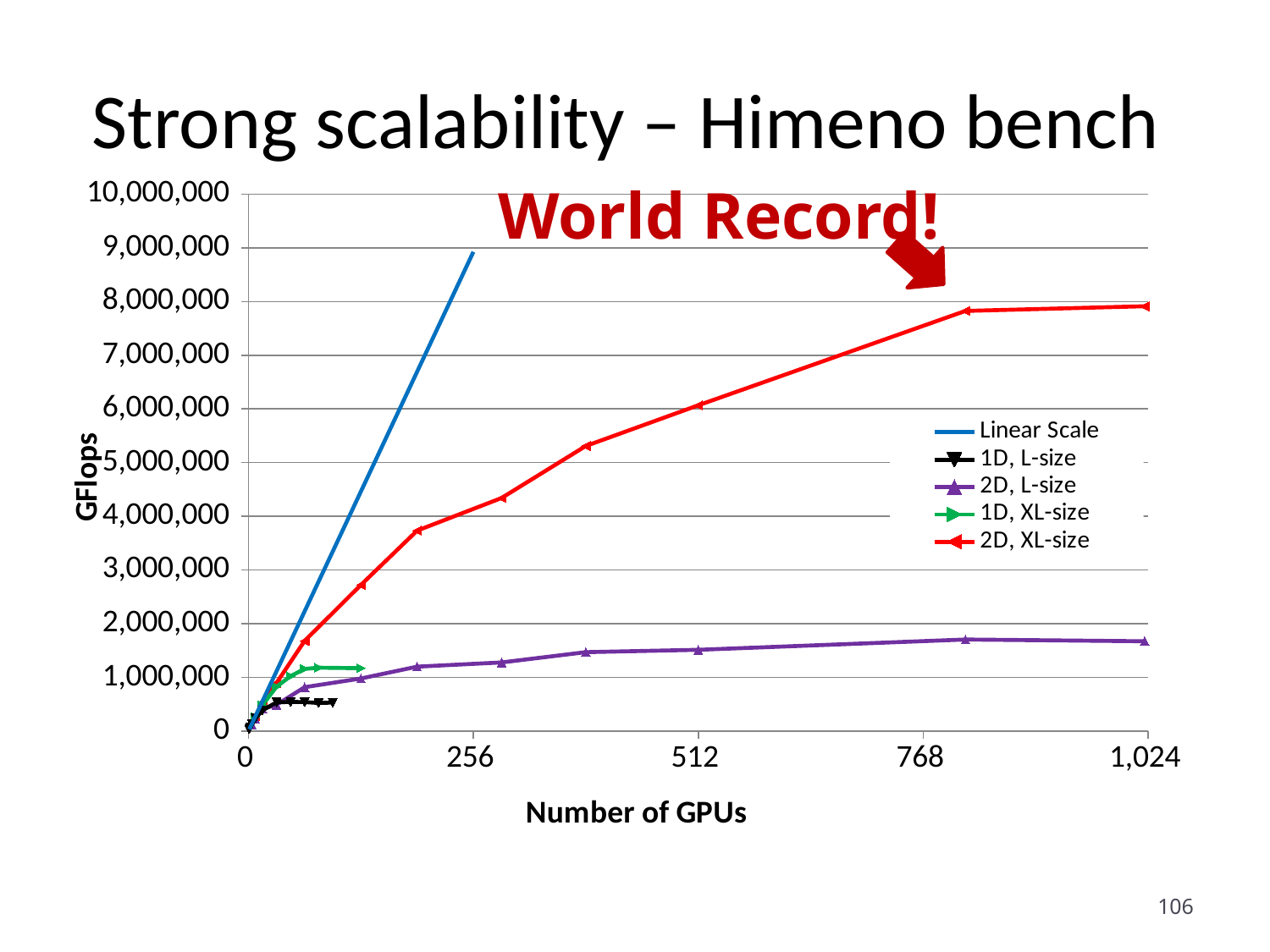
What is the title of the chart on the slide? Strong scalability – Himeno bench Which series reaches the higher value at 1,024 GPUs, 2D, XL-size or 2D, L-size? 2D, XL-size Is the value for 2D, XL-size at 1,024 GPUs greater or less than 7,000,000 GFlops? greater Is the highest value reached by 1D, L-size greater or less than 1,000,000 GFlops? less How many series does the legend list? 5 Which series has the lowest GFlops values on the chart? 1D, L-size Is the value for 2D, L-size at 1,024 GPUs greater or less than 2,000,000 GFlops? less What kind of chart is shown on the slide? line chart What is the label of the x axis? Number of GPUs Does the 2D, XL-size series rise or fall as the number of GPUs increases? rise Which measured series (excluding Linear Scale) reaches the highest GFlops value? 2D, XL-size